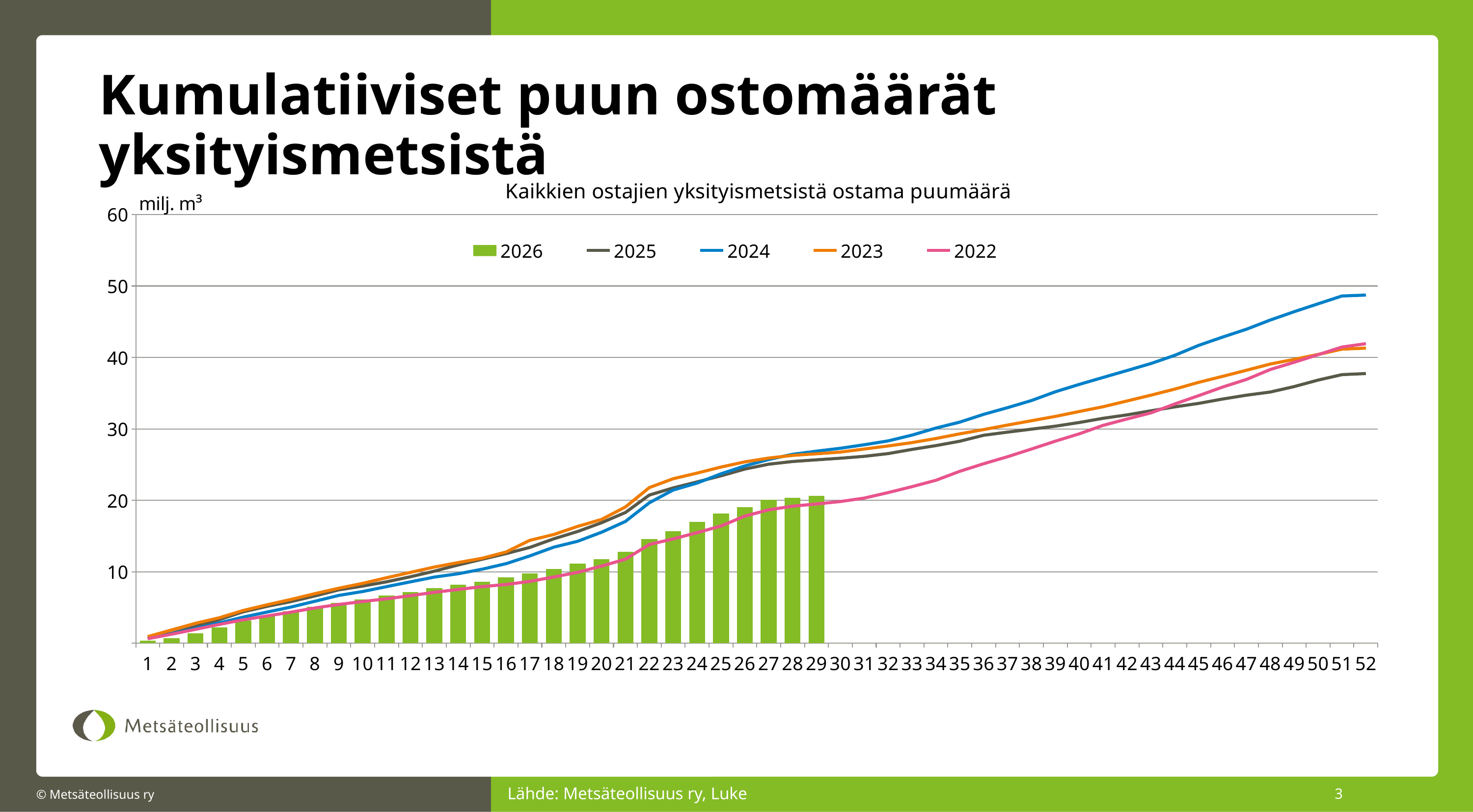
How many weeks are shown on the x axis? 52 Up to which week are bars plotted for the 2026 series? 29 Which series has the highest value at week 52? 2024 Do the line series rise or fall along the x axis? rise Which series has the lowest value at week 52? 2025 What kind of chart is this? Combined bar and line chart At week 30, which is larger, the value for 2023 or the value for 2022? 2023 Which series has the lowest value at week 30? 2022 Is the value for 2024 at week 52 greater or less than 40? greater Is the value for 2026 at week 20 greater or less than 10? greater Is the value for 2022 at week 35 greater or less than 30? less How many series does the legend list? 5